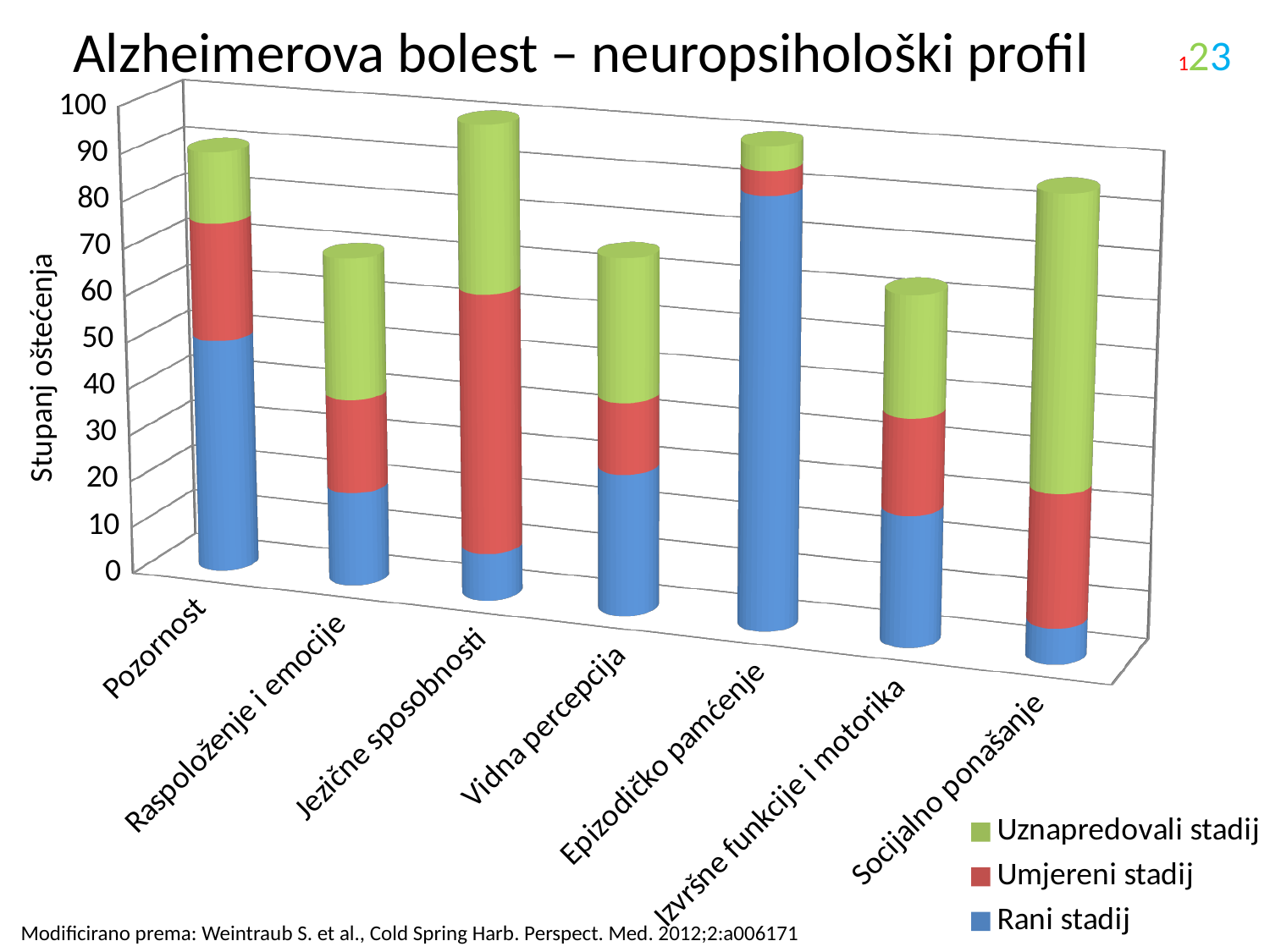
Is the Rani stadij value for Epizodičko pamćenje greater or less than 70? greater How many categories are shown on the x axis of the chart? 7 Which colour represents Uznapredovali stadij in the legend? Green How many series does the chart legend list? 3 Which category has the largest Rani stadij (blue) segment? Epizodičko pamćenje Which has the larger Rani stadij segment, Pozornost or Raspoloženje i emocije? Pozornost What is the title of the chart on the slide? Alzheimerova bolest – neuropsihološki profil What kind of chart is shown on the slide? Stacked bar chart Is the Rani stadij value for Pozornost greater or less than 40? greater